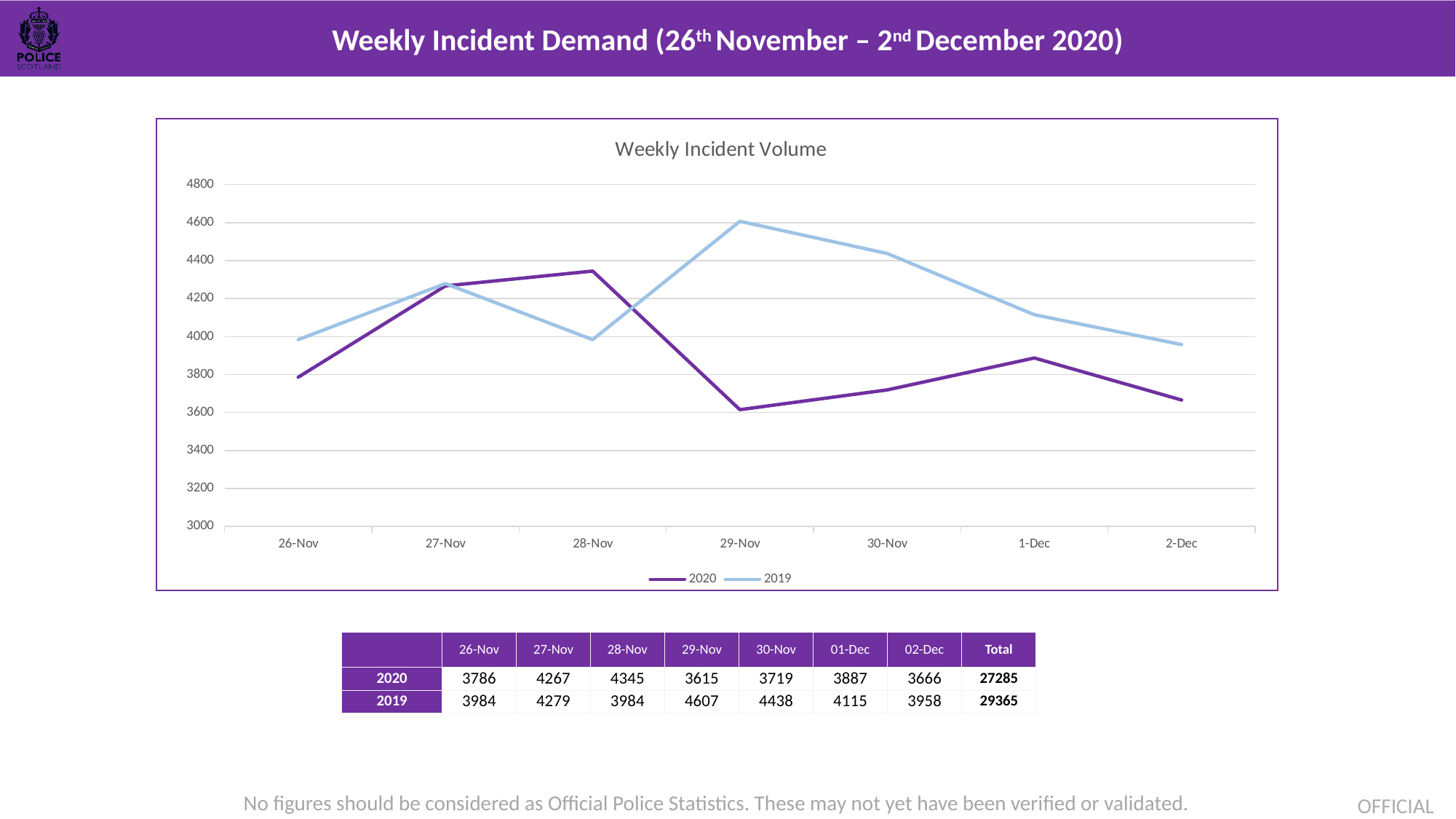
Is the 2019 value for 30-Nov greater or less than 4400? greater On which date does the 2020 series reach its lowest value? 29-Nov Which series has the higher value on 28-Nov, 2020 or 2019? 2020 How many dates are plotted along the x axis of the Weekly Incident Volume chart? 7 What kind of chart is shown on the slide? line chart What is the title of the chart? Weekly Incident Volume How many series does the legend of the Weekly Incident Volume chart list? 2 What is the 2019 value for 29-Nov? 4607 What is the difference between the 2019 and 2020 values on 29-Nov? 992 On which date does the 2019 series reach its highest value? 29-Nov What is the 2020 value for 28-Nov? 4345 Does the 2020 series rise or fall from 1-Dec to 2-Dec? fall